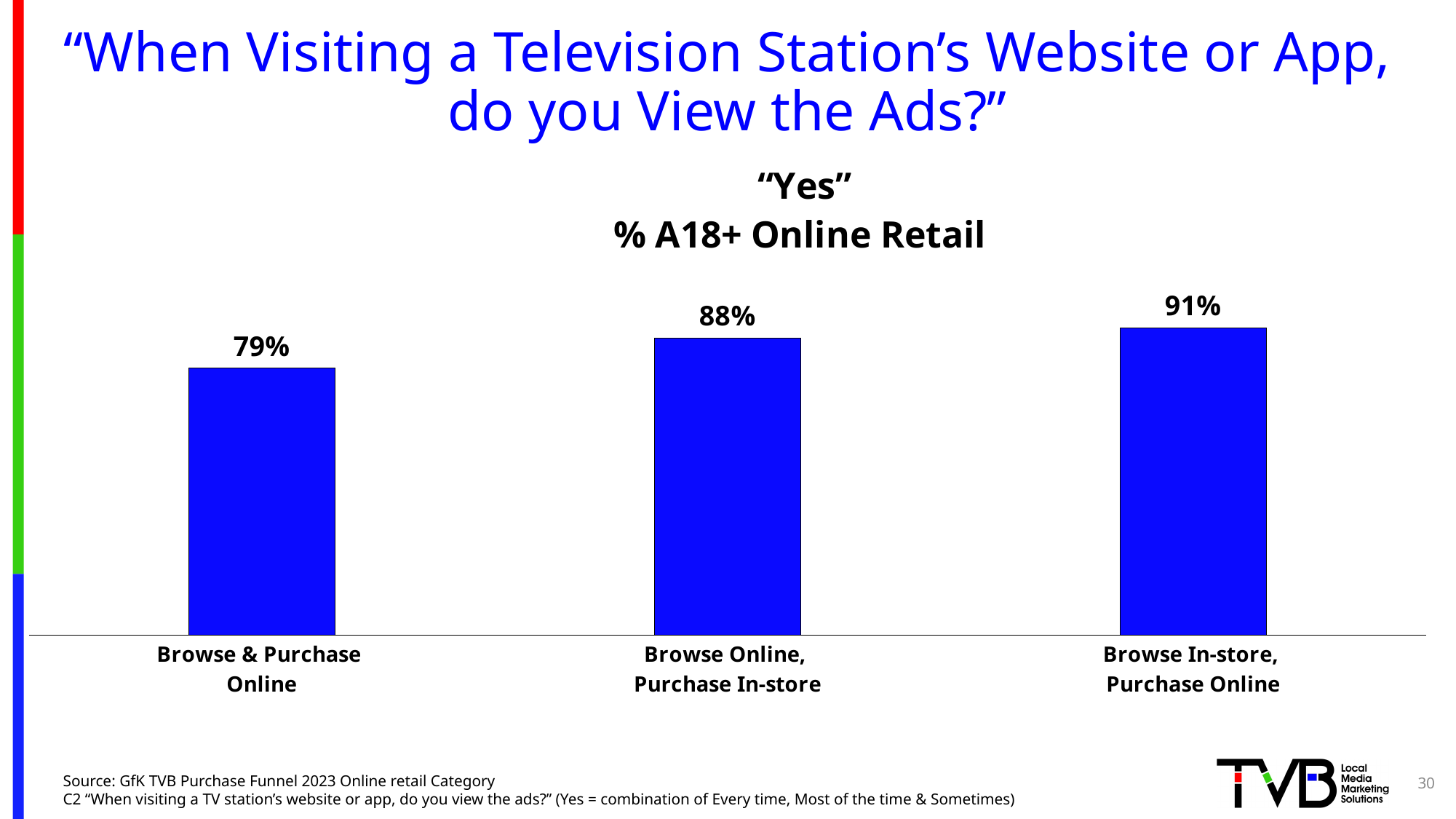
Do the values rise or fall from left to right across the categories? Rise What kind of chart is shown on the slide? Bar chart What is the value for Browse Online, Purchase In-store? 88% What is the title of the chart? "Yes" % A18+ Online Retail Which category has the highest value? Browse In-store, Purchase Online What is the value for Browse In-store, Purchase Online? 91% Which is larger: the value for Browse Online, Purchase In-store or the value for Browse & Purchase Online? Browse Online, Purchase In-store What is the value for Browse & Purchase Online? 79% What is the difference between the values for Browse In-store, Purchase Online and Browse & Purchase Online? 12 percentage points Which category has the lowest value? Browse & Purchase Online What is the difference between the values for Browse Online, Purchase In-store and Browse & Purchase Online? 9 percentage points How many categories are shown in the chart? 3